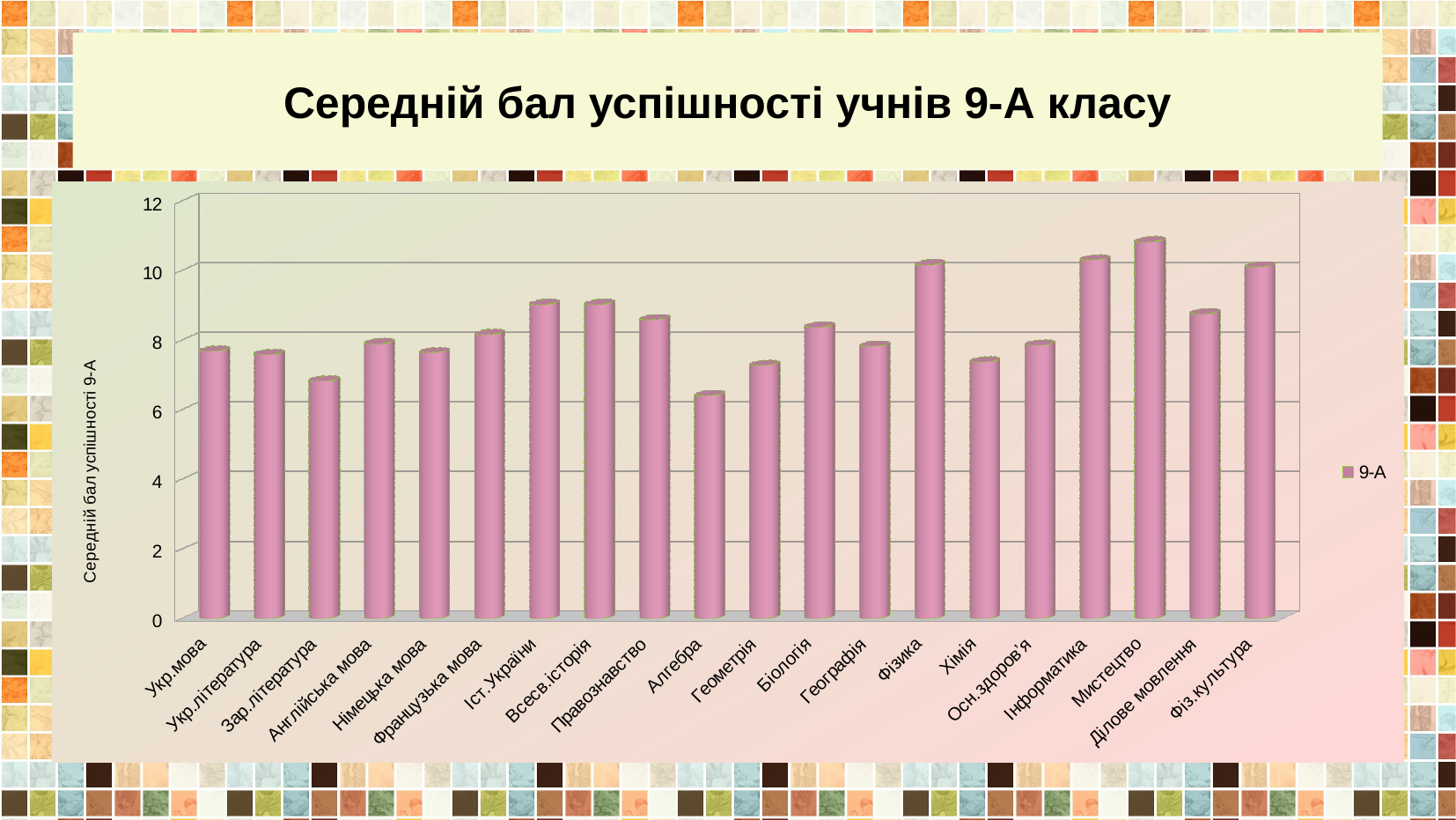
How many subjects (categories) are plotted on the x axis? 20 What is the title of the chart? Середній бал успішності учнів 9-А класу How many series does the legend list? 1 Is the value for Мистецтво greater or less than 10? greater What is the name of the series shown in the legend? 9-А Which subject has the lowest average score? Алгебра Which subject has the highest average score? Мистецтво Which is larger, the value for Фізика or the value for Хімія? Фізика Is the value for Алгебра greater or less than 8? less What kind of chart is shown on the slide? bar chart Is the value for Іст.України greater or less than 8? greater Which is larger, the value for Зар.література or the value for Англійська мова? Англійська мова